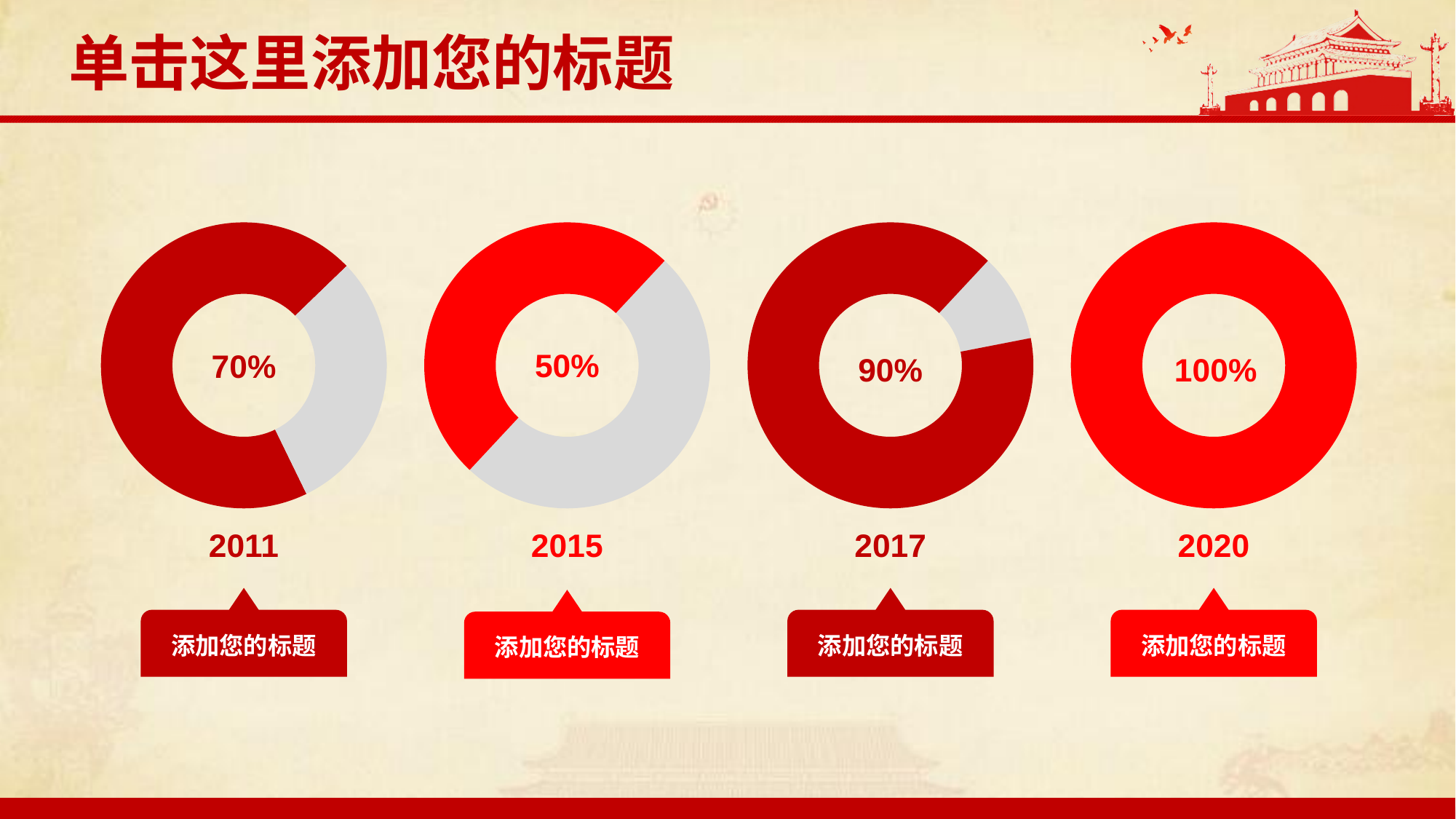
Which year's donut chart shows the highest value? 2020 How many donut charts are shown on the slide? 4 Which is larger, the value for 2011 or the value for 2015? 2011 What value is shown in the donut chart labelled 2011? 70% Which year's donut chart shows the lowest value? 2015 What value is shown in the donut chart labelled 2020? 100% What value is shown in the donut chart labelled 2017? 90% Does the value rise or fall from the 2015 chart to the 2017 chart? Rise What is the difference between the value for 2017 and the value for 2011? 20% What kind of chart is used to show the percentages on the slide? Donut chart What is the difference between the value for 2020 and the value for 2015? 50% What value is shown in the donut chart labelled 2015? 50%